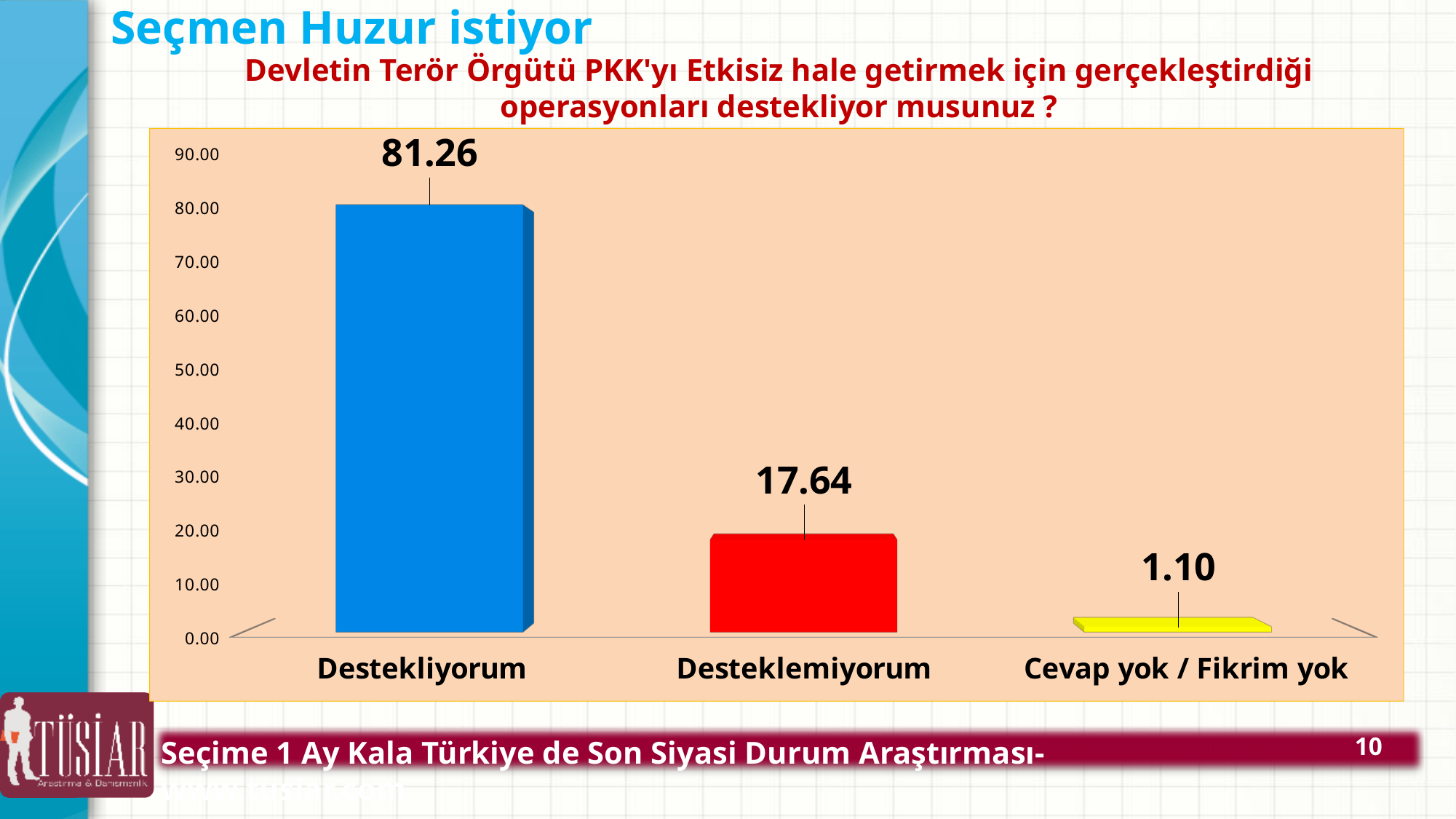
What colour is the bar for Desteklemiyorum? red What is the value for Cevap yok / Fikrim yok? 1.10 Is the value for Destekliyorum greater or less than 80.00? greater What is the difference between the values for Desteklemiyorum and Cevap yok / Fikrim yok? 16.54 What is the value for Destekliyorum? 81.26 Which is larger, the value for Desteklemiyorum or the value for Cevap yok / Fikrim yok? Desteklemiyorum Which category has the lowest value? Cevap yok / Fikrim yok What is the value for Desteklemiyorum? 17.64 How many categories are shown on the x axis? 3 Which category has the highest value? Destekliyorum What kind of chart is shown on the slide? bar chart What is the difference between the values for Destekliyorum and Desteklemiyorum? 63.62